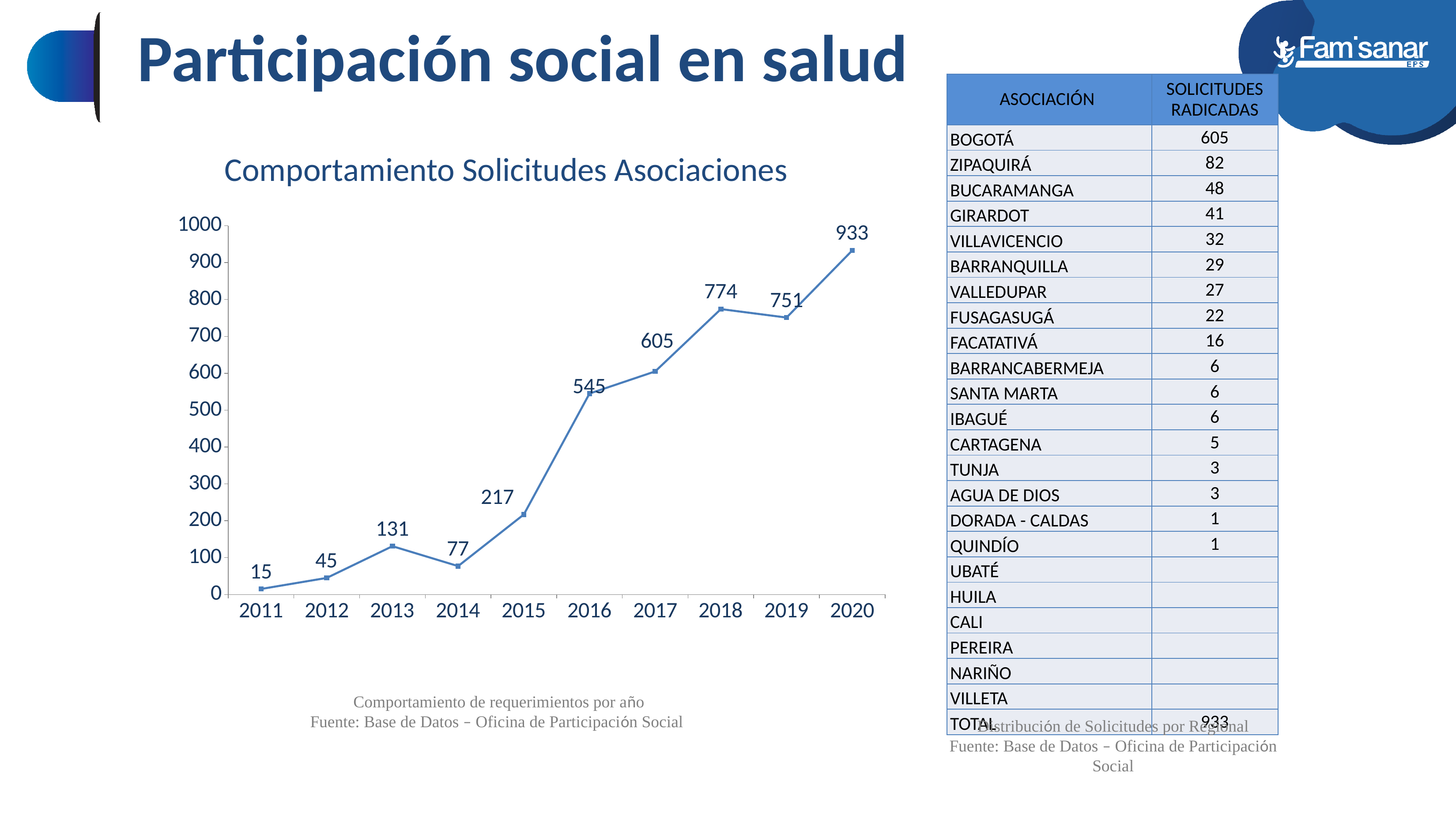
What is the value for 2011 in the 'Comportamiento Solicitudes Asociaciones' chart? 15 In the 'Comportamiento Solicitudes Asociaciones' chart, do the values generally rise or fall from 2011 to 2020? rise Is the value for 2015 in the 'Comportamiento Solicitudes Asociaciones' chart greater or less than 300? less What kind of chart is 'Comportamiento Solicitudes Asociaciones'? line chart What is the difference between the values for 2018 and 2019 in the 'Comportamiento Solicitudes Asociaciones' chart? 23 Which year has the highest value in the 'Comportamiento Solicitudes Asociaciones' chart? 2020 How many years are plotted in the 'Comportamiento Solicitudes Asociaciones' chart? 10 What is the value for 2019 in the 'Comportamiento Solicitudes Asociaciones' chart? 751 What is the value for 2016 in the 'Comportamiento Solicitudes Asociaciones' chart? 545 In the 'Comportamiento Solicitudes Asociaciones' chart, which is larger, the value for 2013 or the value for 2014? 2013 Which year has the lowest value in the 'Comportamiento Solicitudes Asociaciones' chart? 2011 What is the difference between the values for 2020 and 2017 in the 'Comportamiento Solicitudes Asociaciones' chart? 328